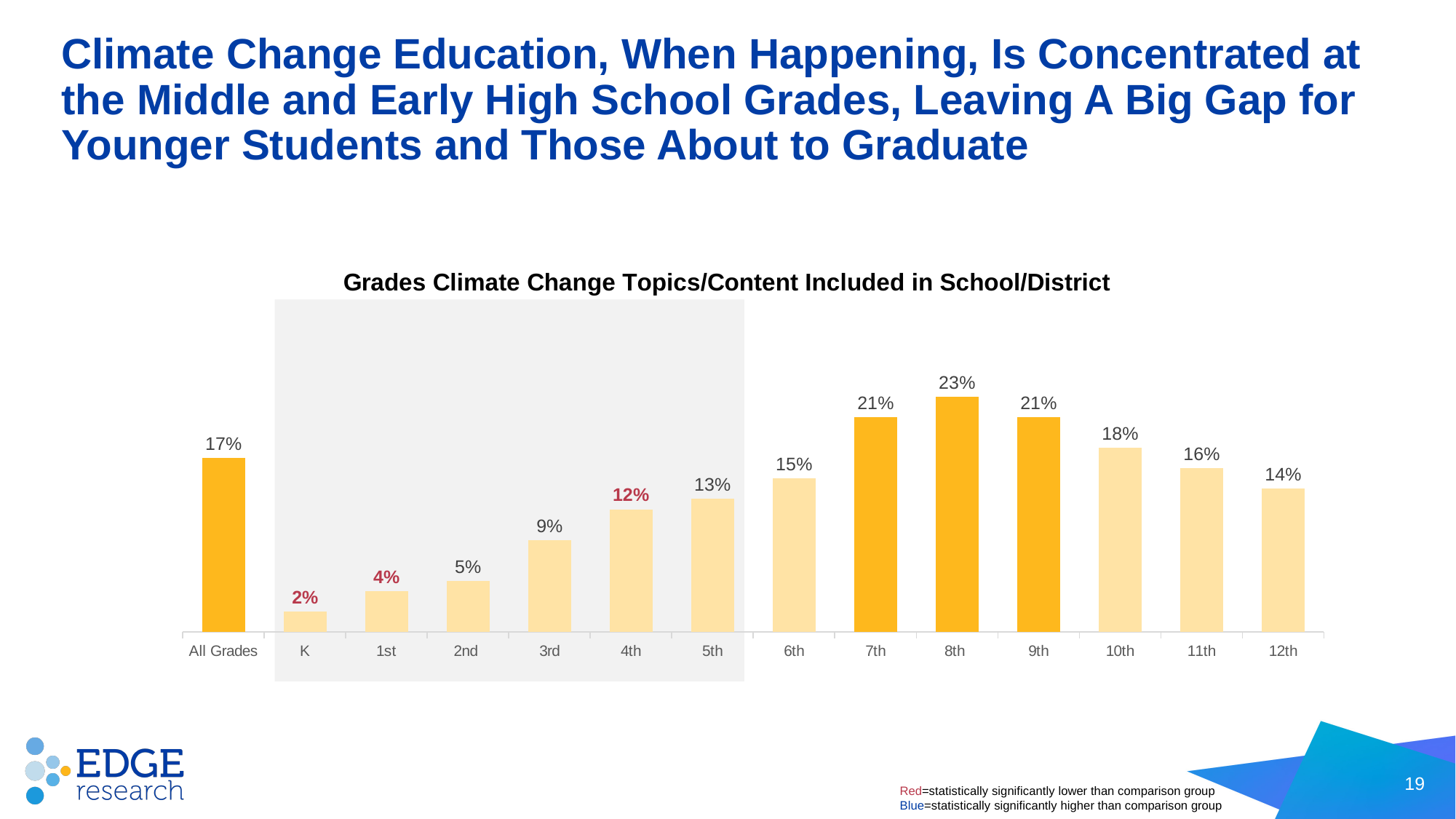
What is the value for 12th grade? 14% How many categories are shown on the x axis? 14 What is the value for 8th grade? 23% Which grade has the lowest value? K What kind of chart is shown on the slide? Bar chart What is the title of the chart? Grades Climate Change Topics/Content Included in School/District What is the difference between the values for 8th grade and 5th grade? 10% What is the value for K (kindergarten)? 2% What is the value for All Grades? 17% Which grade has the highest value? 8th Do the values rise or fall from K through 8th grade? Rise Which is larger, the value for 6th grade or the value for 10th grade? 10th